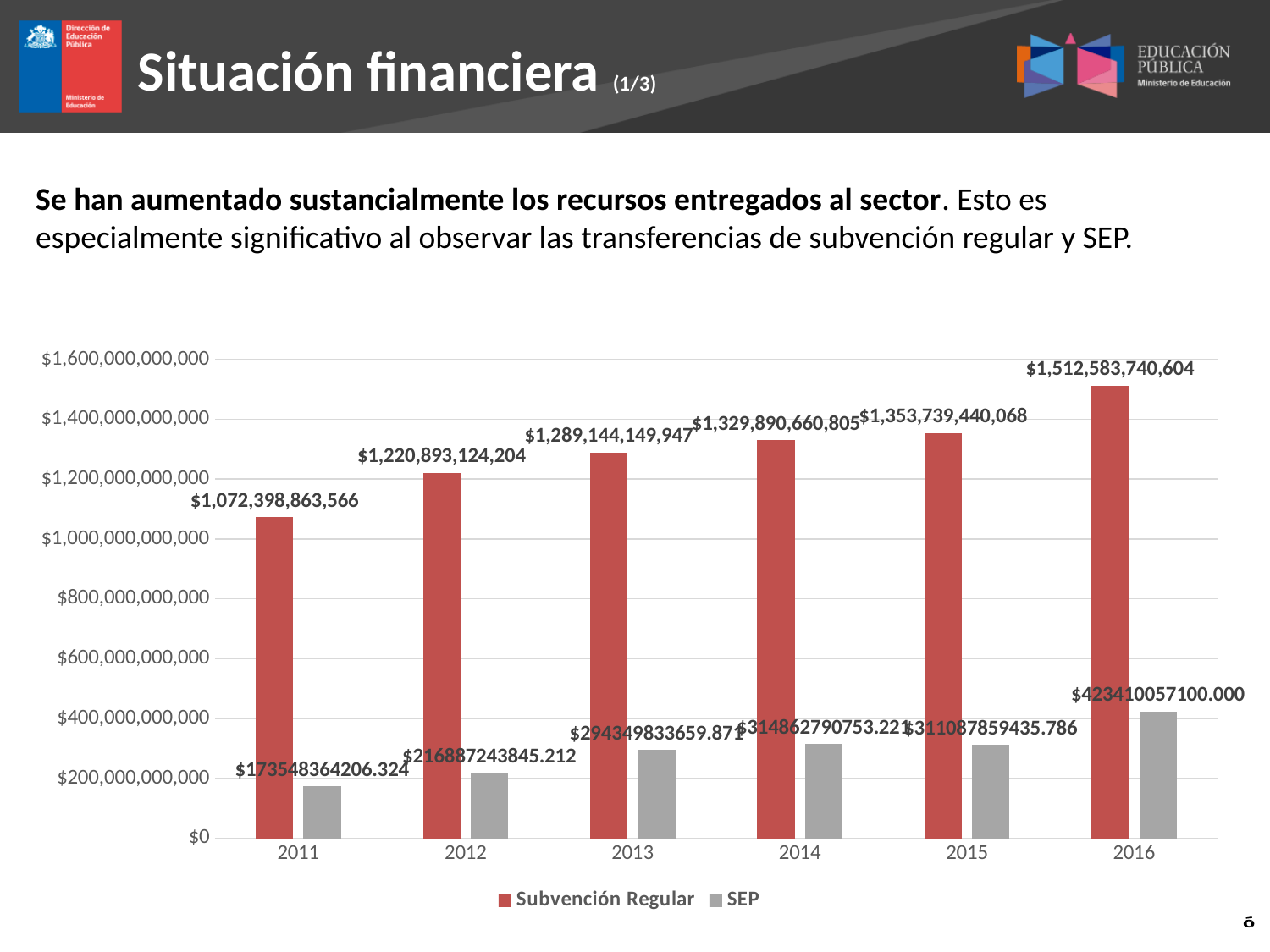
What is the value of SEP for 2016? $423410057100.000 How many years are shown on the x axis? 6 What kind of chart is shown on the slide? bar chart What is the difference between Subvención Regular in 2016 and in 2011? $440,184,877,038 What is the value of Subvención Regular for 2016? $1,512,583,740,604 How many series does the legend list? 2 Does Subvención Regular rise or fall from 2011 to 2016? rise What is the value of Subvención Regular for 2011? $1,072,398,863,566 In which year is Subvención Regular highest? 2016 In which year is SEP lowest? 2011 Is the SEP value for 2016 greater or less than $400,000,000,000? greater Which year has the larger Subvención Regular value, 2014 or 2015? 2015